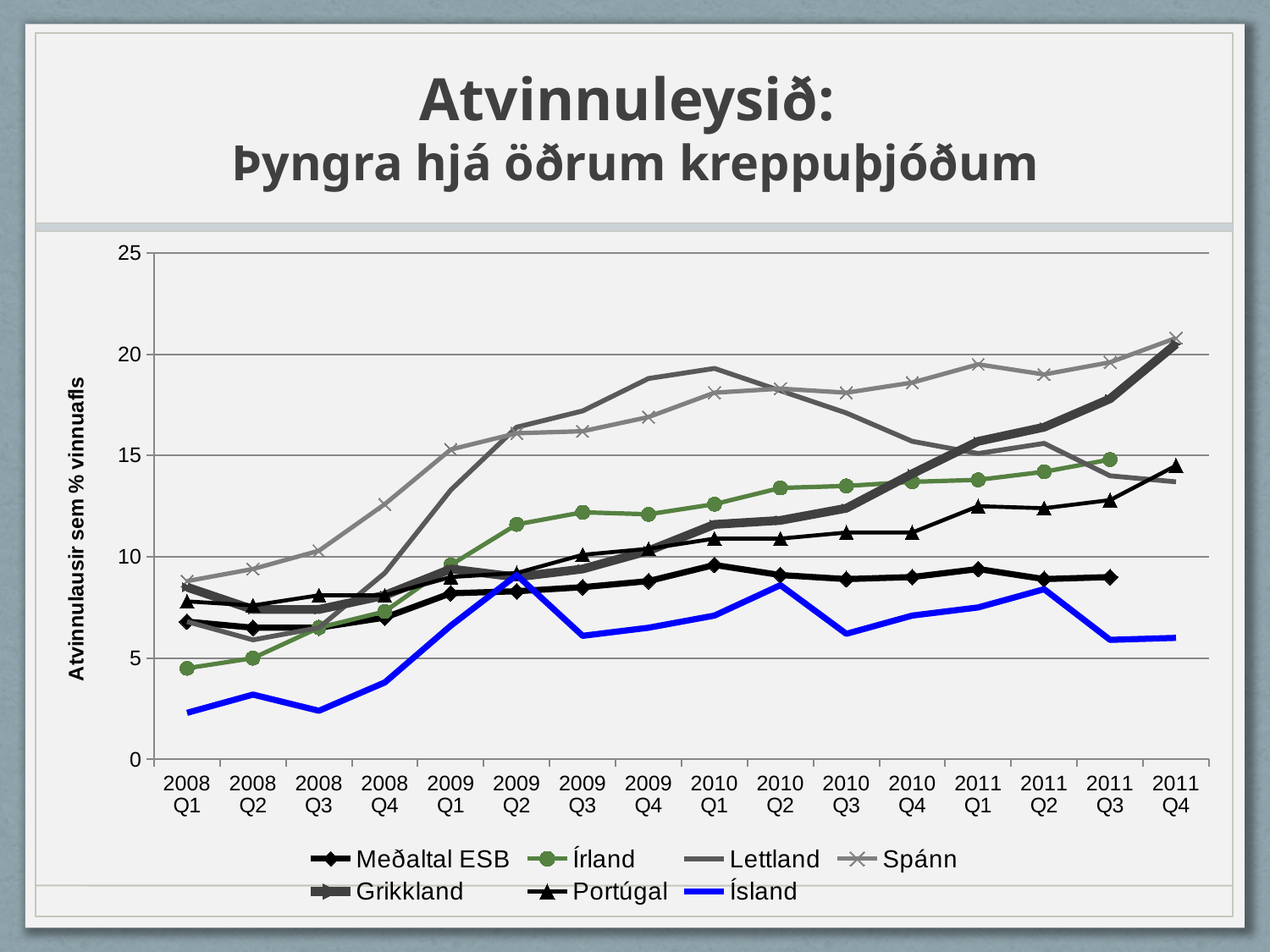
How many series does the legend list? 7 Which series has the lowest value in 2011 Q4? Ísland Is the value for Ísland in 2008 Q1 greater or less than 5? less What is the label on the y axis? Atvinnulausir sem % vinnuafls In 2010 Q1, which is larger, the value for Lettland or the value for Írland? Lettland Which series has the highest value in 2010 Q1? Lettland Is the value for Spánn in 2011 Q4 greater or less than 20? greater How many quarters are shown along the x axis? 16 Is the value for Lettland in 2010 Q1 greater or less than 15? greater Does the value for Írland generally rise or fall from 2008 Q1 to 2011 Q4? rise What kind of chart is shown on the slide? line chart